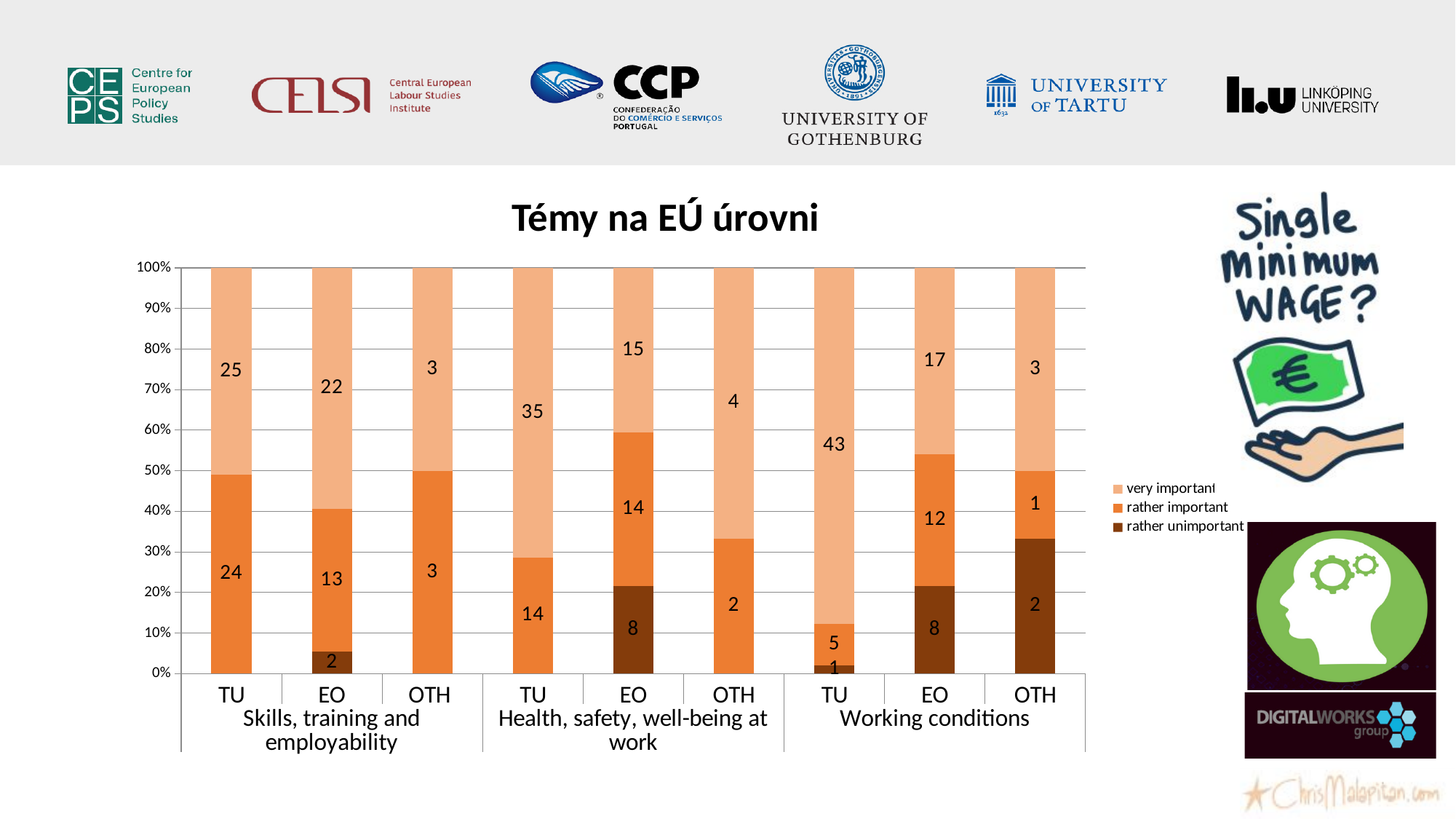
Which is larger: the 'rather important' label for TU under Skills, training and employability or for TU under Health, safety, well-being at work? TU under Skills, training and employability What is the data label for the 'rather unimportant' segment of the EO bar under Health, safety, well-being at work? 8 What is the data label for the 'very important' segment of the OTH bar under Health, safety, well-being at work? 4 What is the title of the chart? Témy na EÚ úrovni How many series does the legend list? 3 What is the difference between the 'very important' labels for TU under Working conditions and TU under Health, safety, well-being at work? 8 What kind of chart is shown on the slide? Stacked bar chart What is the data label for the 'very important' segment of the TU bar under Working conditions? 43 Which bar has the largest 'very important' data label? TU under Working conditions What is the data label for the 'rather important' segment of the EO bar under Skills, training and employability? 13 How many bars are plotted in the chart? 9 Is the top of the 'rather unimportant' segment for OTH under Working conditions greater or less than 30%? greater